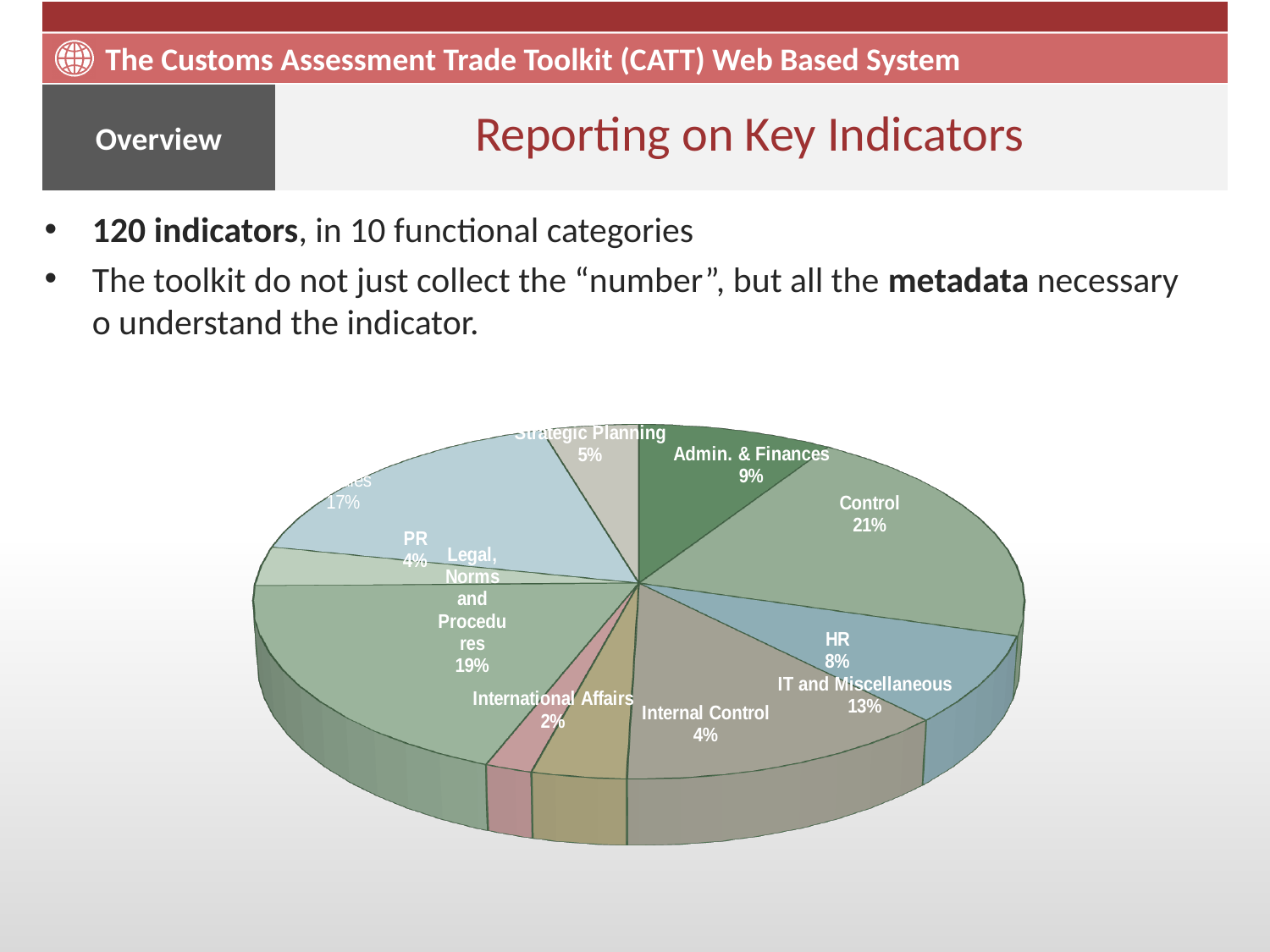
What kind of chart is shown on the slide? pie chart What is the value shown for Strategic Planning? 5% What is the value shown for IT and Miscellaneous? 13% Which is larger, the share for IT and Miscellaneous or the share for Admin. & Finances? IT and Miscellaneous Which category has the largest share of the pie? Control What is the value shown for PR? 4% What is the value shown for Legal, Norms and Procedures? 19% What is the difference in percentage points between Control and HR? 13 What share of the pie does Control represent? 21% How many slices does the pie chart have? 10 What is the value shown for Admin. & Finances? 9% Which category has the smallest share of the pie? International Affairs